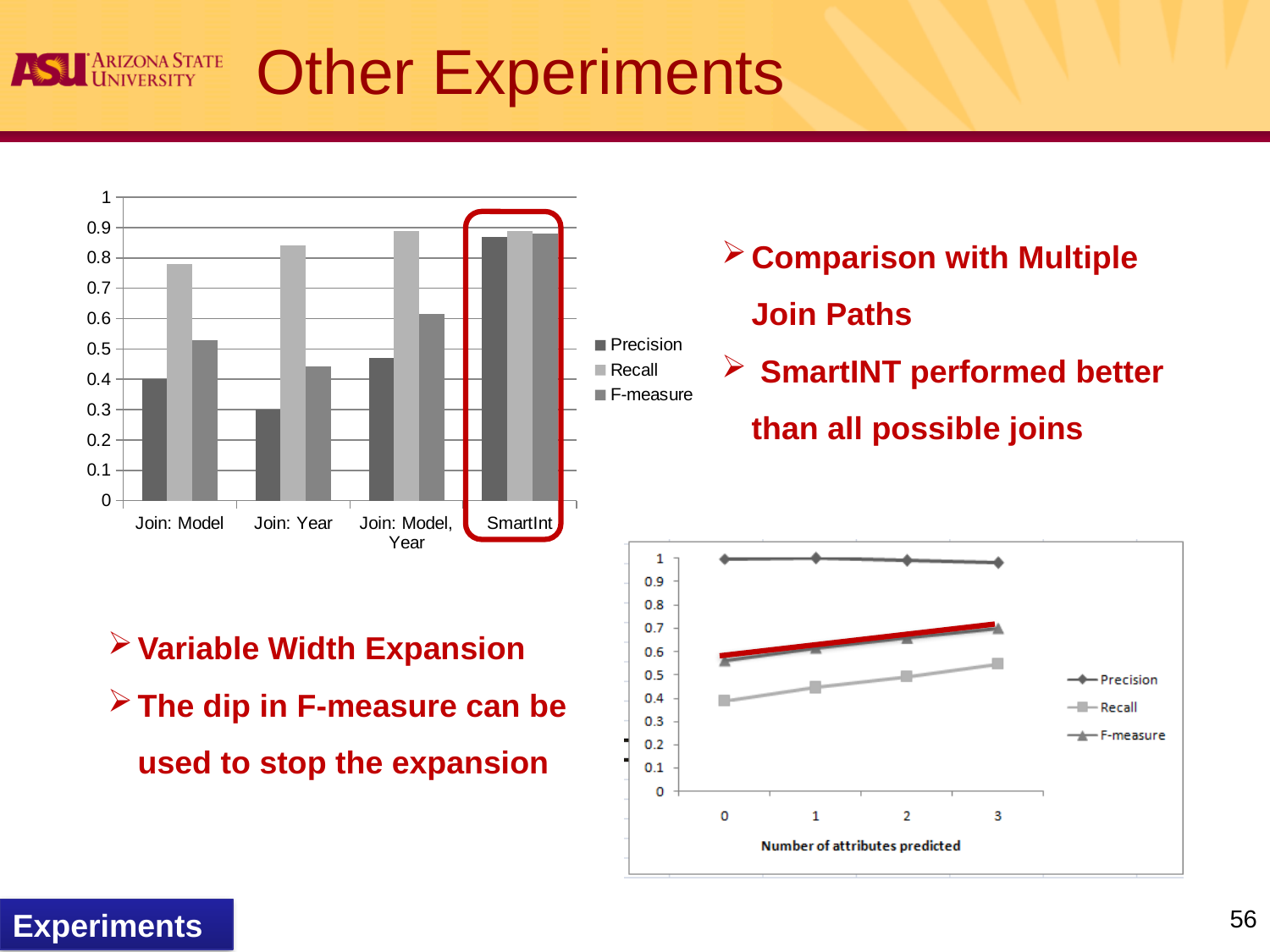
In the bar chart on the left, how many categories are shown on the x axis? 4 What type of chart is the chart on the left of the slide? bar chart In the bar chart on the left, is the Recall value for Join: Model greater or less than 0.7? greater What type of chart is the chart on the bottom right of the slide? line chart In the bar chart on the left, is the F-measure value for Join: Year greater or less than 0.5? less In the line chart on the bottom right, is the Recall value at 0 attributes predicted greater or less than 0.5? less In the bar chart on the left, which category has the highest Precision bar? SmartInt In the bar chart on the left, which is larger for Join: Model, Year: Precision or Recall? Recall In the line chart on the bottom right, what is the x-axis title? Number of attributes predicted In the bar chart on the left, how many series does the legend list? 3 In the line chart on the bottom right, does the Recall line rise or fall as the number of attributes predicted increases? rise In the bar chart on the left, which category has the lowest Precision bar? Join: Year